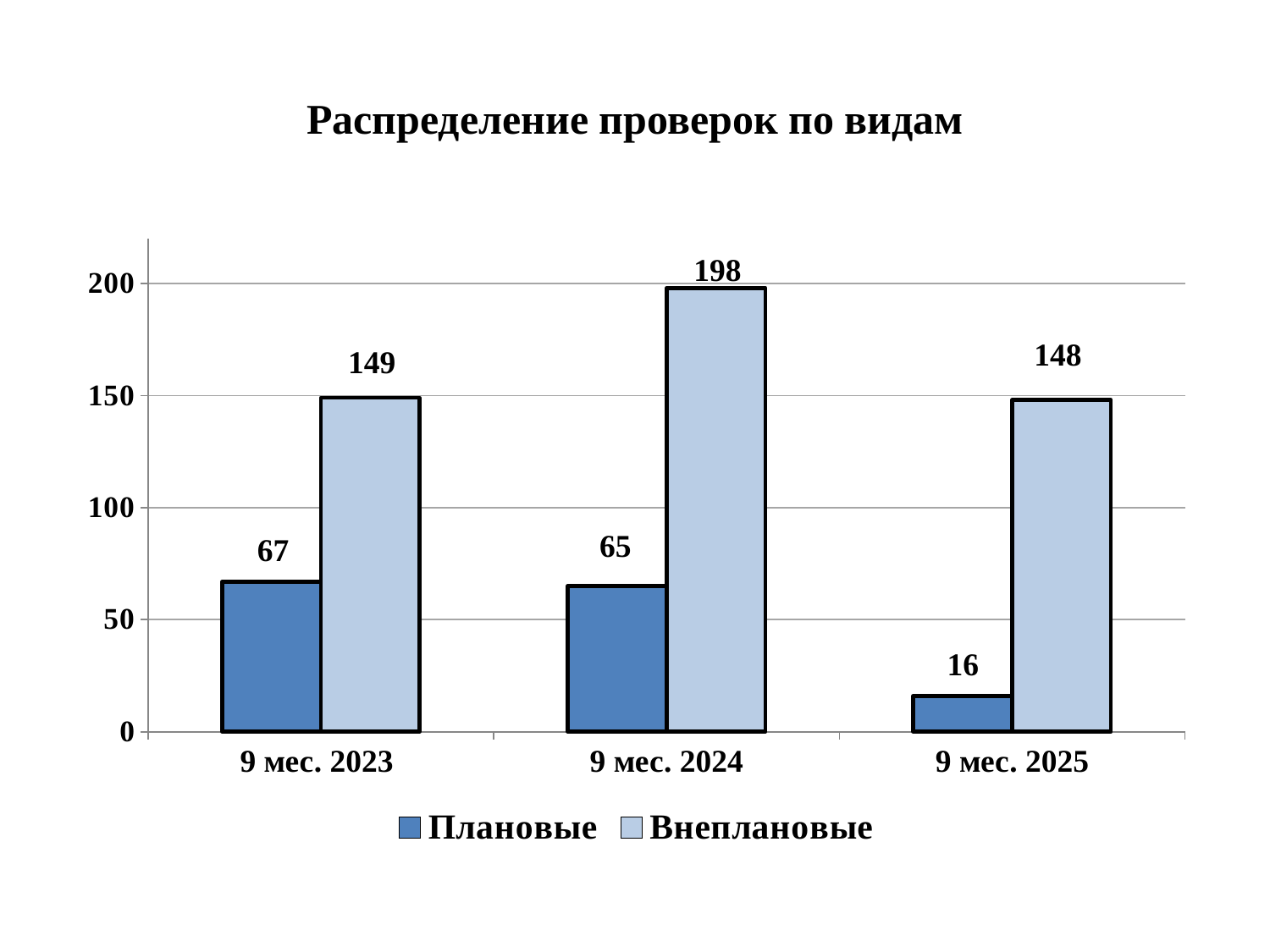
How many series does the legend list? 2 What is the value for Внеплановые in 9 мес. 2024? 198 What is the value for Плановые in 9 мес. 2023? 67 How many periods are shown on the x axis? 3 Which period has the highest value for Внеплановые? 9 мес. 2024 What is the value for Плановые in 9 мес. 2025? 16 What is the difference between Внеплановые in 9 мес. 2023 and 9 мес. 2025? 1 What kind of chart is shown on the slide? bar chart What is the title of the chart? Распределение проверок по видам What is the difference between Внеплановые and Плановые in 9 мес. 2024? 133 Which is larger: Плановые in 9 мес. 2023 or Плановые in 9 мес. 2024? Плановые in 9 мес. 2023 Which period has the lowest value for Плановые? 9 мес. 2025